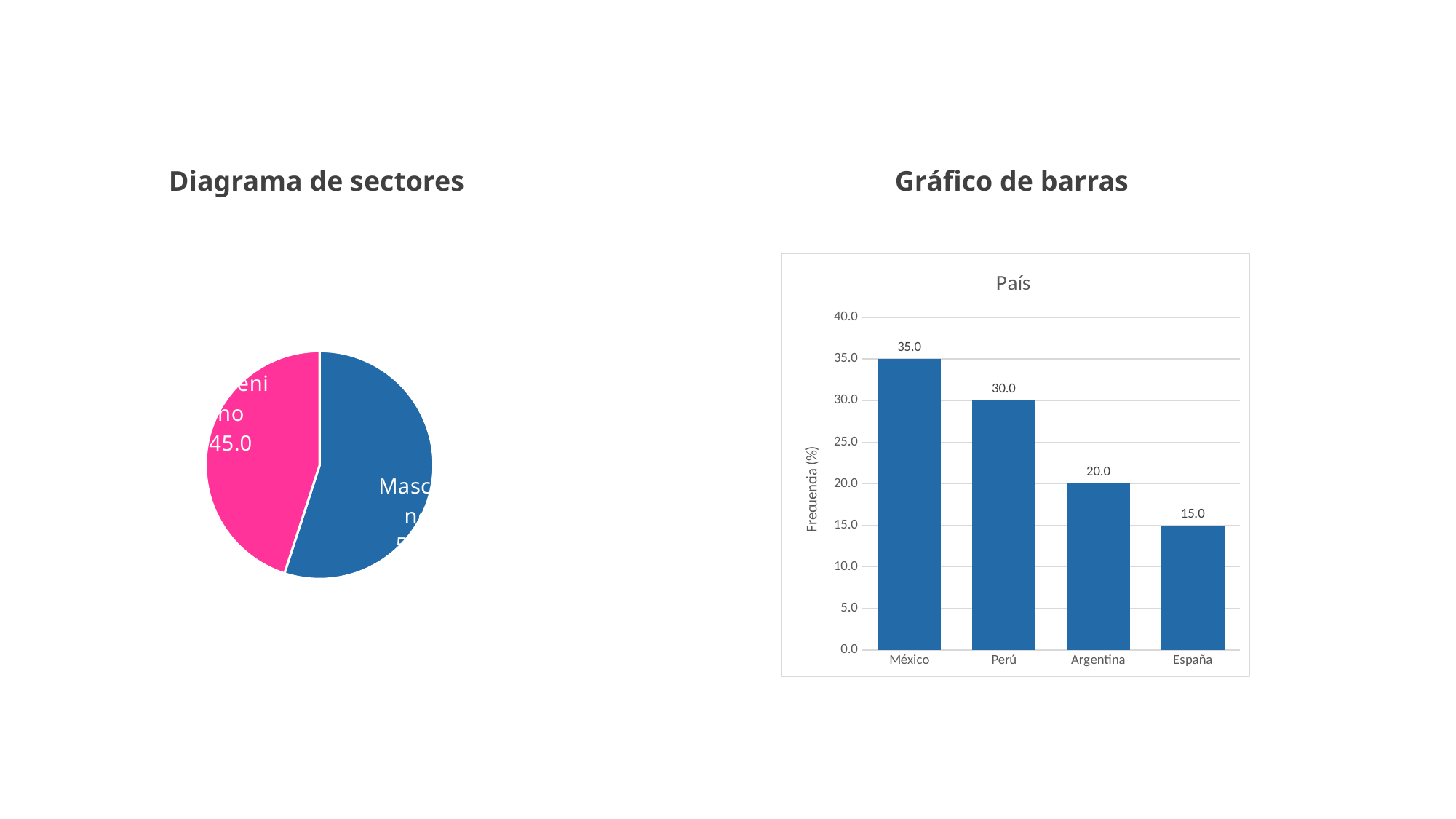
In the bar chart titled 'País', which country has the highest value? México In the bar chart titled 'País', what is the label of the vertical axis? Frecuencia (%) In the bar chart titled 'País', what is the value for España? 15.0 In the bar chart titled 'País', how many countries are shown? 4 In the bar chart titled 'País', what is the value for Perú? 30.0 In the bar chart titled 'País', which country has the lowest value? España In the bar chart titled 'País', what is the value for México? 35.0 In the bar chart titled 'País', what is the value for Argentina? 20.0 In the bar chart titled 'País', which is larger, the value for Perú or the value for Argentina? Perú What kind of chart is shown on the left side of the slide under 'Diagrama de sectores'? pie chart In the bar chart titled 'País', do the values rise or fall from left to right? fall In the bar chart titled 'País', what is the difference between the values for México and España? 20.0